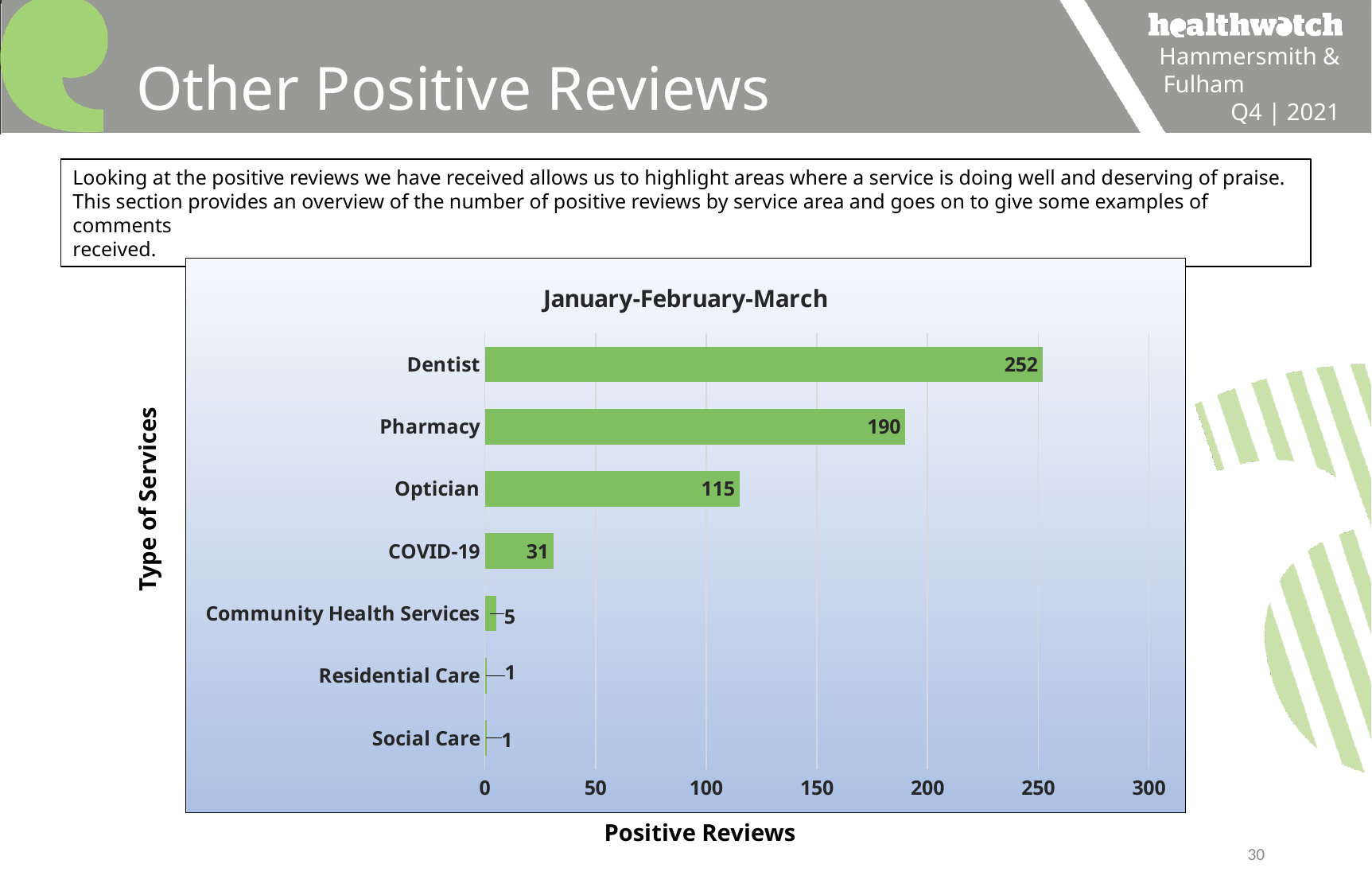
What is the value for COVID-19? 31 What kind of chart is shown on the slide? Bar chart What is the difference in positive reviews between Dentist and Pharmacy? 62 Which has more positive reviews, Optician or COVID-19? Optician What is the label of the horizontal axis? Positive Reviews How many positive reviews are shown for Optician? 115 What is the title of the chart? January-February-March How many positive reviews did Dentist receive? 252 Which type of service has the highest number of positive reviews? Dentist What is the value for Pharmacy? 190 How many types of services are shown in the chart? 7 Is the value for Pharmacy greater or less than 150? greater